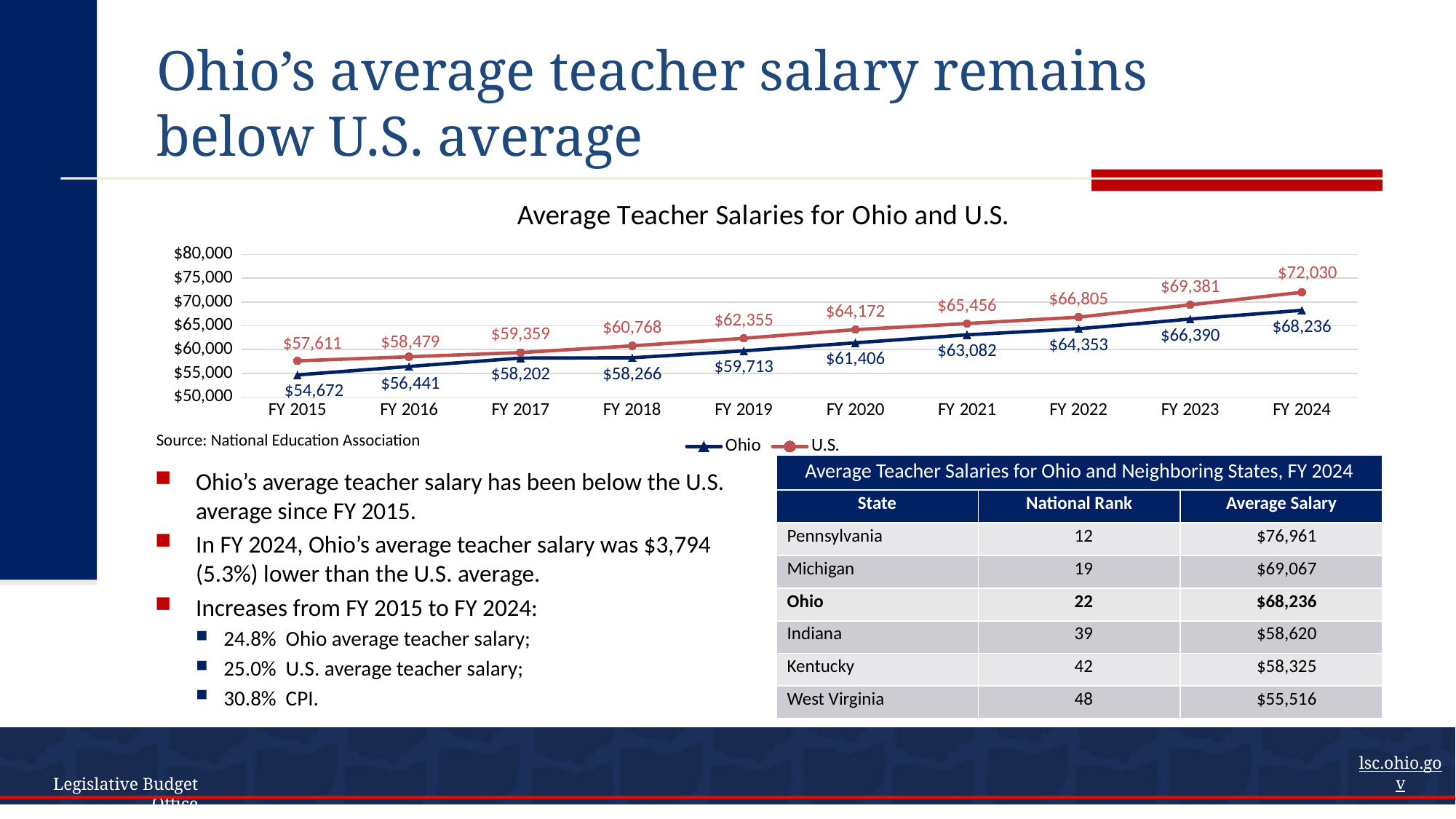
Which was larger in FY 2020, Ohio's average teacher salary or the U.S. average teacher salary? U.S. How many fiscal years are plotted on the x axis of the chart? 10 What was Ohio's average teacher salary in FY 2015 according to the chart? $54,672 What is the difference between the U.S. and Ohio average teacher salaries in FY 2015? $2,939 What was the U.S. average teacher salary in FY 2019? $62,355 How many series does the chart's legend list? 2 What was the U.S. average teacher salary in FY 2024 according to the chart? $72,030 In which fiscal year was Ohio's average teacher salary lowest on the chart? FY 2015 What type of chart is used to show Average Teacher Salaries for Ohio and U.S.? line chart What is the difference between the U.S. and Ohio average teacher salaries in FY 2024? $3,794 In which fiscal year was the U.S. average teacher salary highest on the chart? FY 2024 What was Ohio's average teacher salary in FY 2021? $63,082